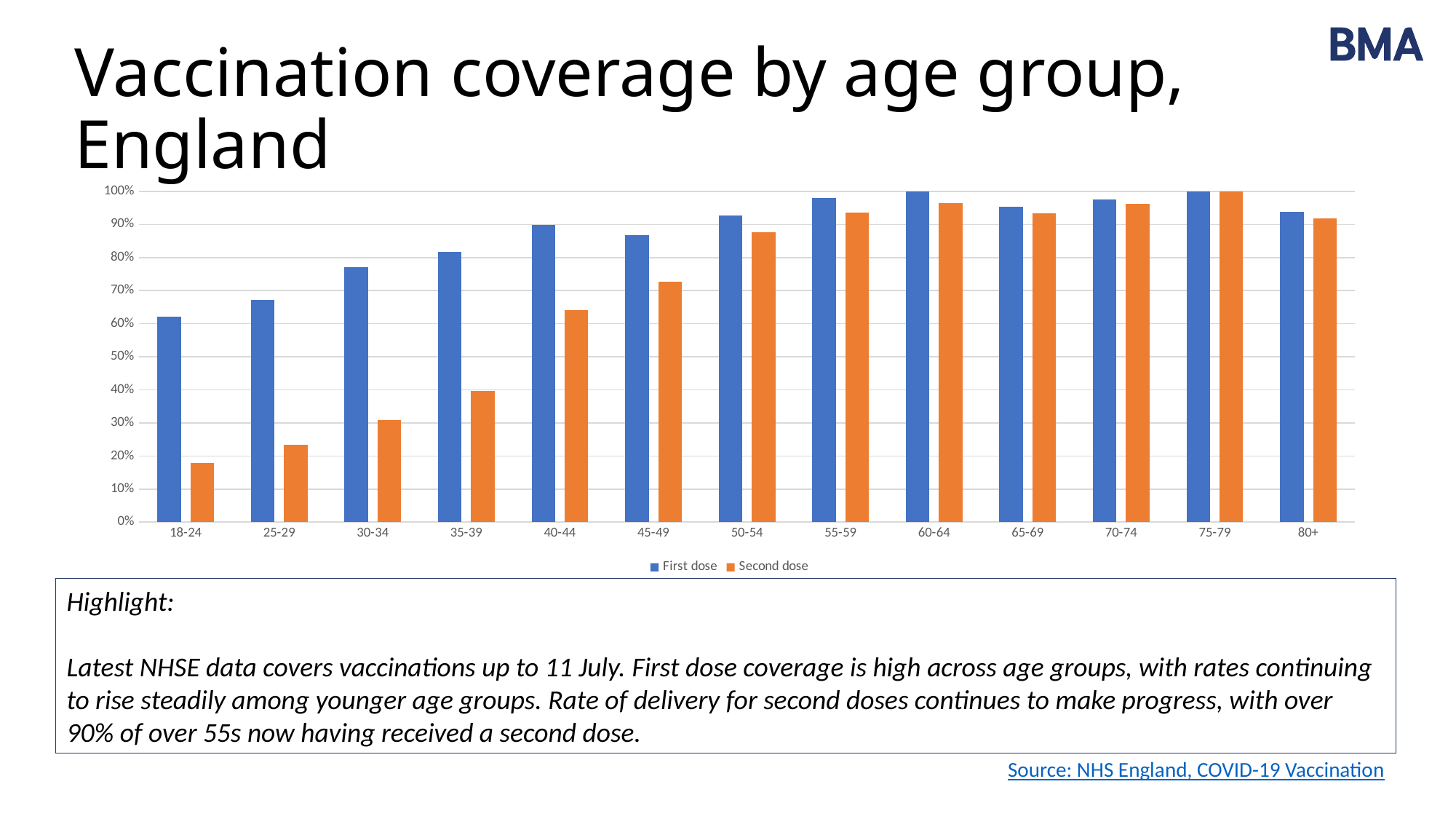
Is the first dose value for 30-34 greater or less than 70%? greater How many age groups are shown on the x axis of the chart? 13 How many series does the chart's legend list? 2 Do second dose values rise or fall from 18-24 to 50-54? Rise Which age group has the lowest first dose coverage? 18-24 Is the second dose value for 40-44 greater or less than 60%? greater Which is larger, the second dose value for 45-49 or for 50-54? 50-54 Is the first dose value for 45-49 greater or less than 90%? less Which age group has the highest second dose coverage? 75-79 Which age group has the lowest second dose coverage? 18-24 What kind of chart is shown on the slide? Bar chart